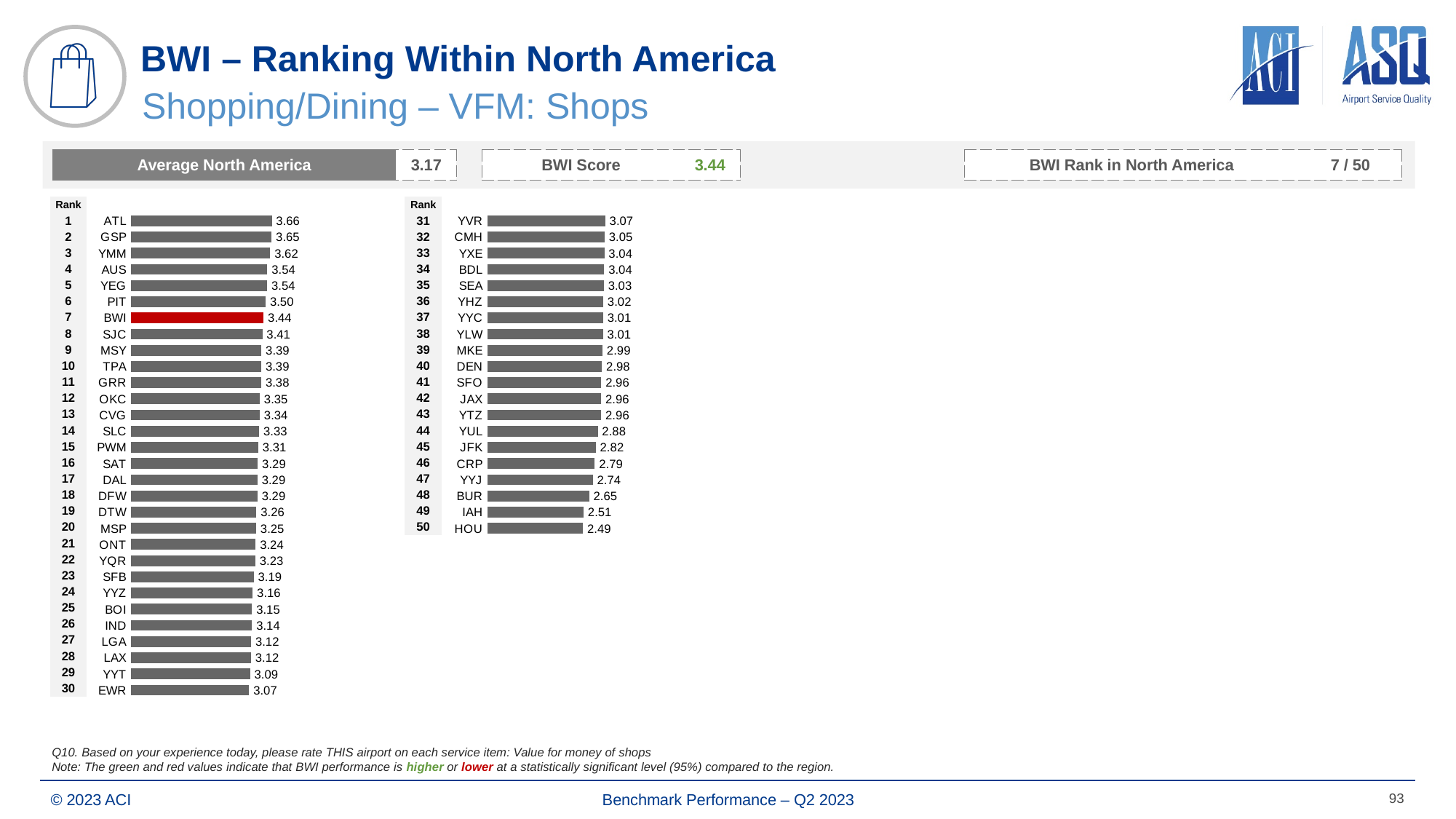
Which airport has the lowest value on the right chart (ranks 31–50)? HOU Which airport has the highest value on the left chart (ranks 1–30)? ATL What is the value for HOU on the right chart (ranks 31–50)? 2.49 What is the value for BWI on the left chart (ranks 1–30)? 3.44 How many airports are plotted on the right chart (ranks 31–50)? 20 How many airports are plotted on the left chart (ranks 1–30)? 30 On the left chart (ranks 1–30), which bar is coloured red? BWI On the right chart (ranks 31–50), which is larger, the value for YVR or the value for JFK? YVR What is the difference between the values for IAH and HOU on the right chart (ranks 31–50)? 0.02 What is the difference between the values for ATL and BWI on the left chart (ranks 1–30)? 0.22 What is the value for YUL on the right chart (ranks 31–50)? 2.88 What kind of chart is the left chart (ranks 1–30)? Bar chart